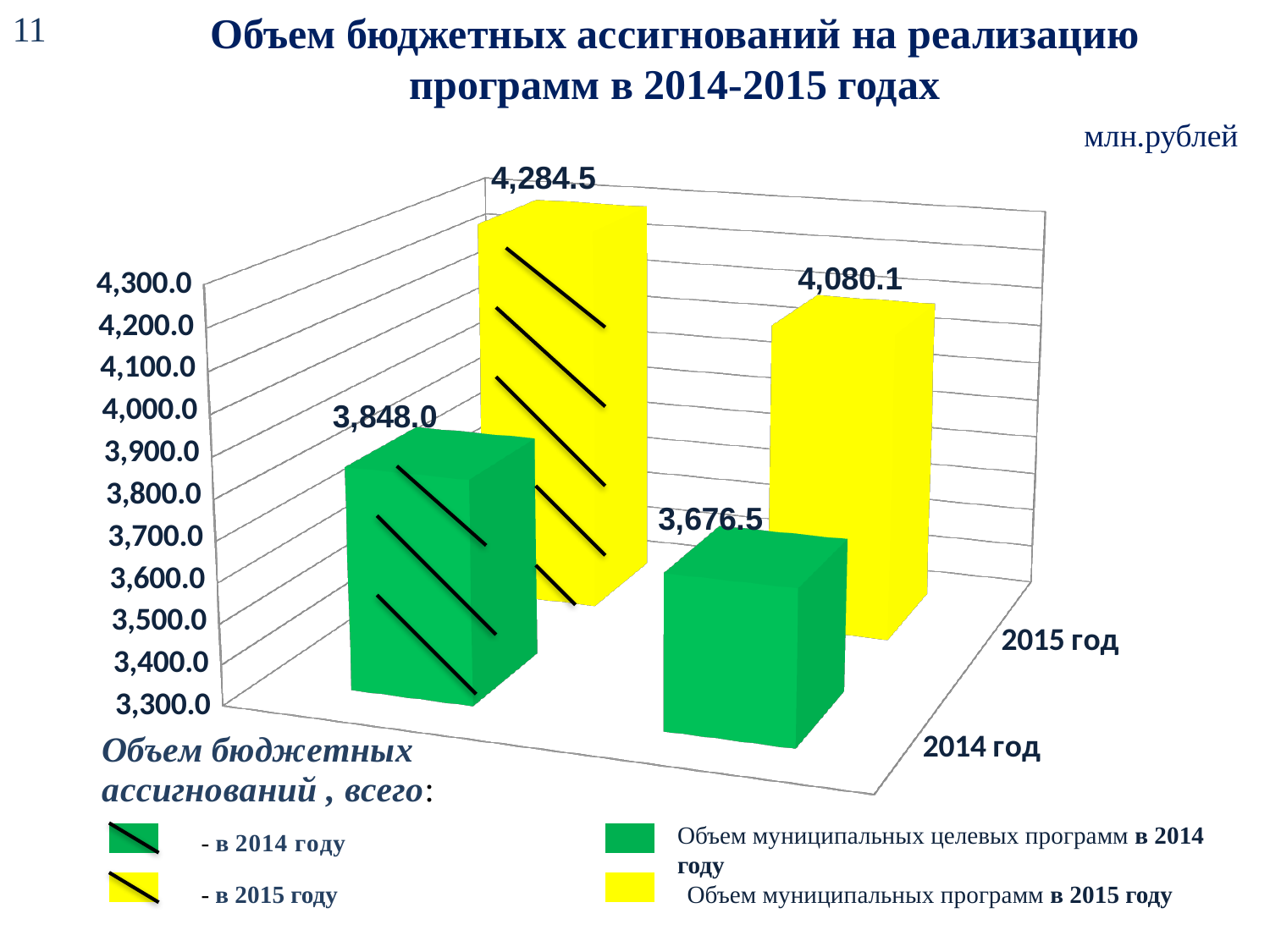
What is the total volume of budget allocations in 2014 (the hatched green bar)? 3,848.0 In what units are the values on the chart expressed? млн.рублей Which bar has the highest value on the chart? Total budget allocations in 2015 (4,284.5) What is the total volume of budget allocations in 2015 (the hatched yellow bar)? 4,284.5 What is the value for the volume of municipal programs in 2015 (the plain yellow bar)? 4,080.1 What is the value for the volume of municipal target programs in 2014 (the plain green bar)? 3,676.5 Which bar has the lowest value on the chart? Municipal target programs in 2014 (3,676.5) How many bars are plotted on the chart? 4 What type of chart is shown on the slide? Bar chart Which is larger: the total budget allocations in 2014 or the municipal programs in 2015? Municipal programs in 2015 What is the difference between the municipal programs value in 2015 and the municipal target programs value in 2014? 403.6 What is the difference between the total budget allocations in 2015 and in 2014? 436.5